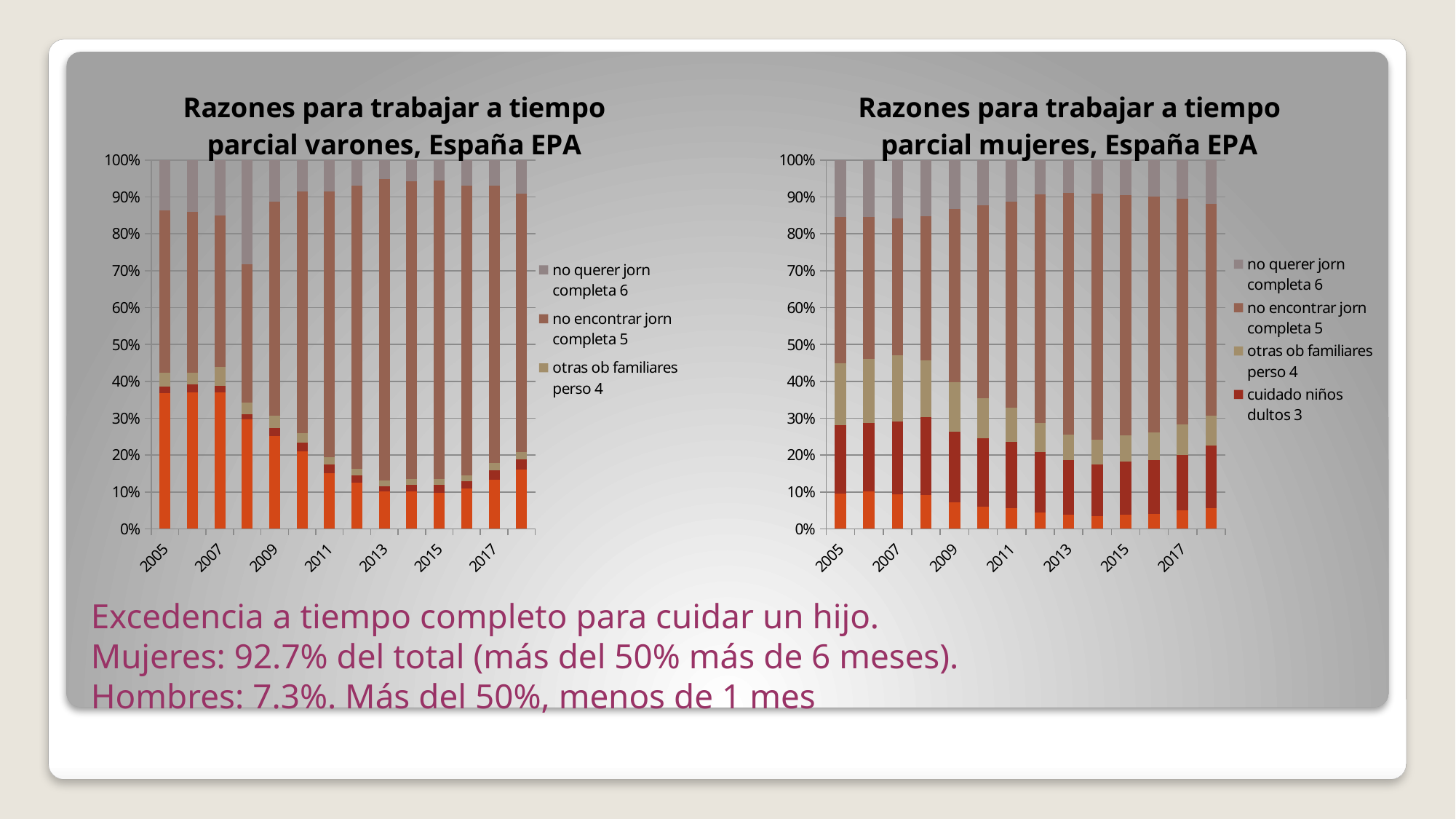
In the right chart, 'Razones para trabajar a tiempo parcial mujeres, España EPA', which legend entry is shown in dark red? cuidado niños dultos 3 In the right chart, 'Razones para trabajar a tiempo parcial mujeres, España EPA', is the 'no querer jorn completa 6' segment larger in 2005 or in 2013? 2005 In the left chart, 'Razones para trabajar a tiempo parcial varones, España EPA', is the top of the bottom orange segment for 2005 greater or less than 30%? greater How many series does the legend of the right chart, 'Razones para trabajar a tiempo parcial mujeres, España EPA', list? 4 How many bars (years) are plotted in the right chart, 'Razones para trabajar a tiempo parcial mujeres, España EPA'? 14 In the left chart, 'Razones para trabajar a tiempo parcial varones, España EPA', does the bottom orange segment rise or fall from 2005 to 2013? fall In the right chart, 'Razones para trabajar a tiempo parcial mujeres, España EPA', is the top of the 'no encontrar jorn completa 5' segment for 2005 greater or less than 80%? greater In the right chart, 'Razones para trabajar a tiempo parcial mujeres, España EPA', is the top of the 'cuidado niños dultos 3' segment for 2018 greater or less than 30%? less What kind of chart is the left chart, 'Razones para trabajar a tiempo parcial varones, España EPA'? stacked bar chart How many series does the legend of the left chart, 'Razones para trabajar a tiempo parcial varones, España EPA', list? 3 What is the title of the left chart? Razones para trabajar a tiempo parcial varones, España EPA